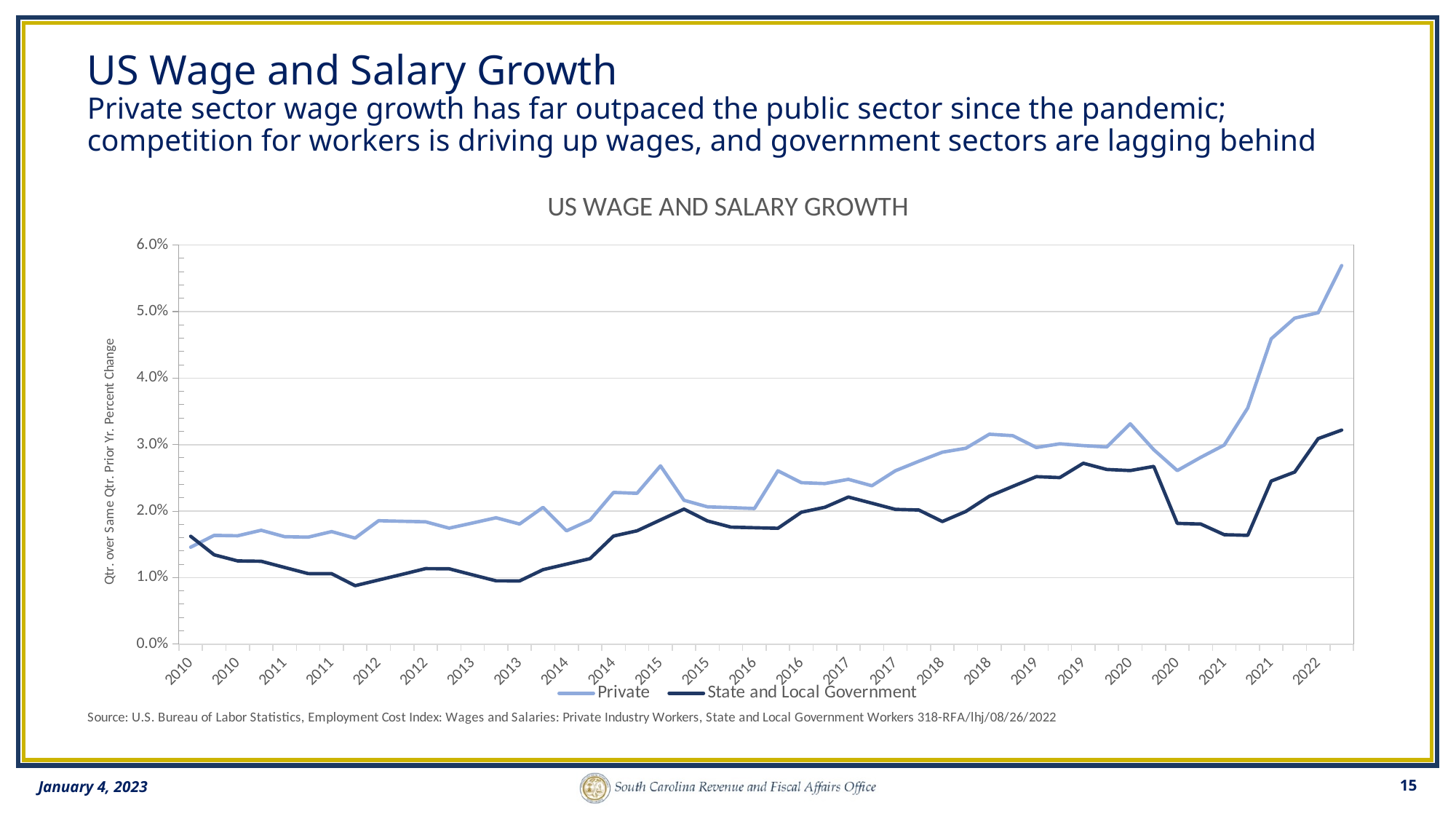
What are the two series named in the chart's legend? Private; State and Local Government Which series reaches the highest value anywhere on the chart? Private What is the label on the chart's vertical axis? Qtr. over Same Qtr. Prior Yr. Percent Change What kind of chart is shown on the slide? Line chart Which series has the lower value at the 2013 points on the chart? State and Local Government Is the final 2022 value of the Private series greater or less than 5.0%? greater Does the Private series rise or fall between the second 2020 point and the end of 2022? rise Is the lowest value of the State and Local Government series greater or less than 1.0%? less Is the final 2022 value of the State and Local Government series greater or less than 3.0%? greater At the last point on the chart (2022), which series has the larger value, Private or State and Local Government? Private How many series does the chart's legend list? 2